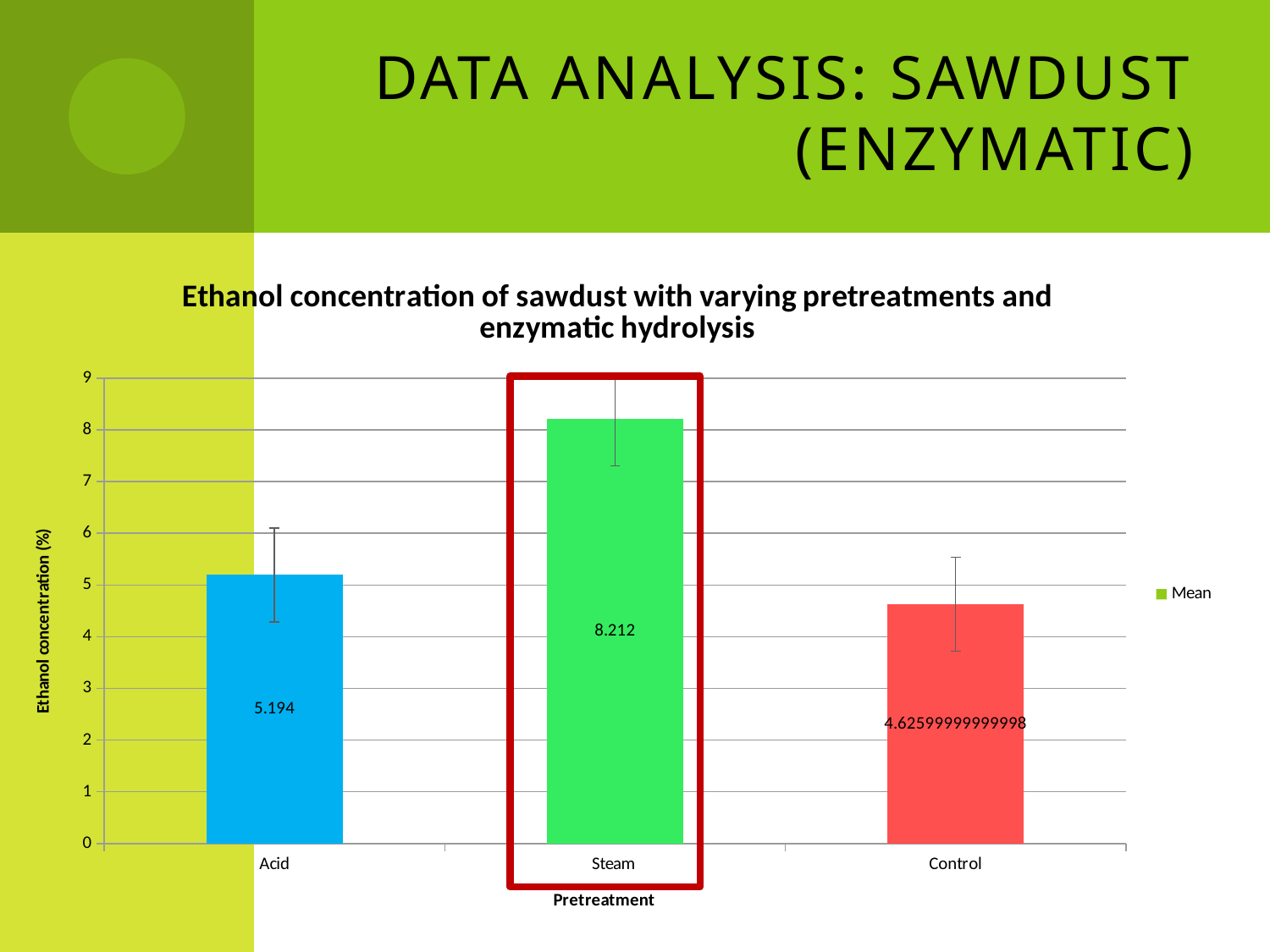
Which has a higher ethanol concentration, Acid or Control? Acid What is the ethanol concentration value shown for the Acid pretreatment? 5.194 Is the value for Control greater or less than 5? less What is the difference between the ethanol concentration for Steam and for Acid? 3.018 Which pretreatment has the highest ethanol concentration? Steam Which pretreatment has the lowest ethanol concentration? Control How many pretreatment categories are shown on the chart? 3 What kind of chart is shown on the slide? Bar chart What is the ethanol concentration value shown for the Steam pretreatment? 8.212 What value is labelled on the Control bar? 4.62599999999998 What is the label of the y axis? Ethanol concentration (%) How many series does the legend list? 1